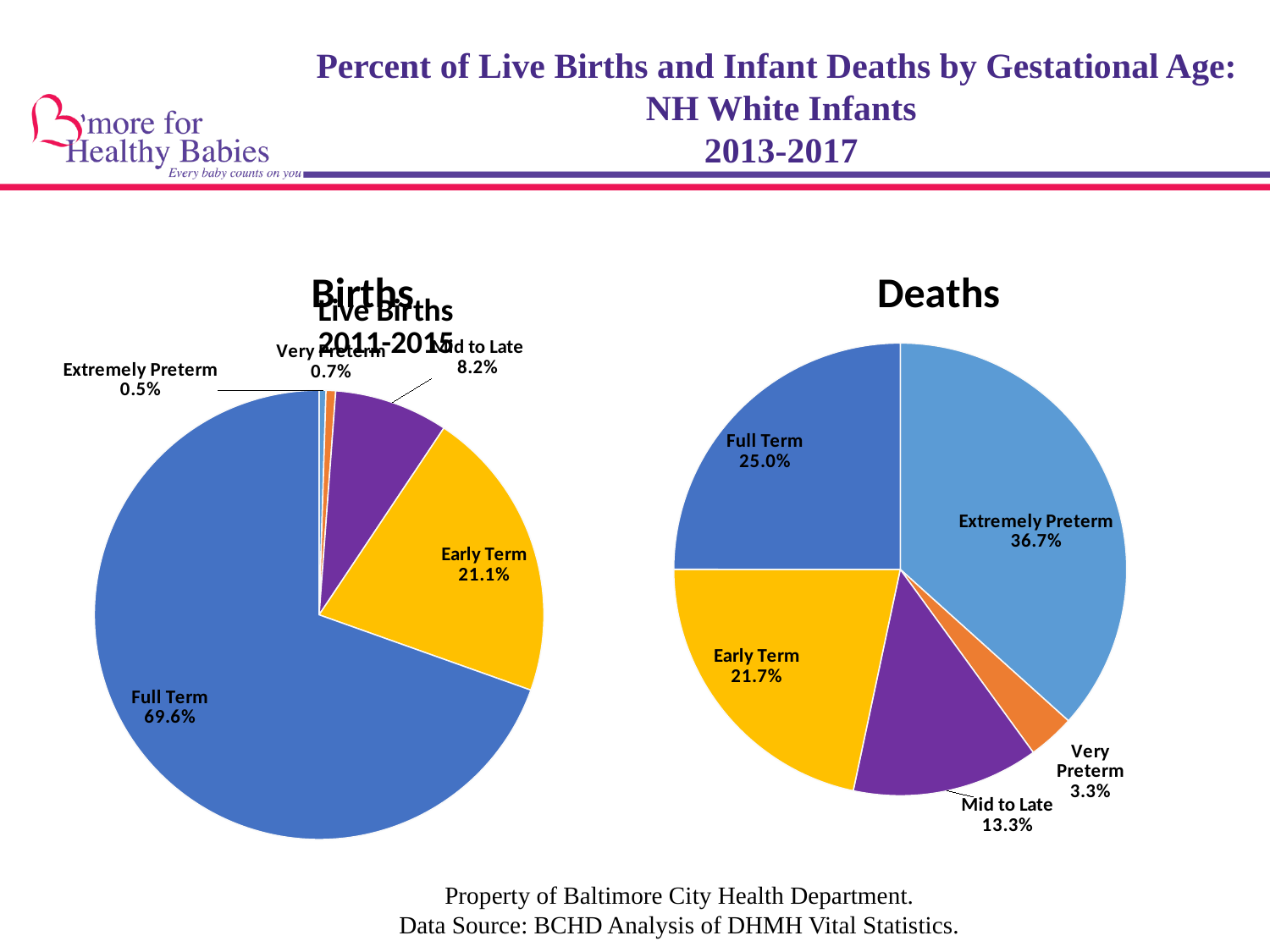
In the Deaths pie chart on the right, which category has the smallest share? Very Preterm In the Births pie chart on the left, what is the value for Early Term? 21.1% In the Births pie chart on the left, which gestational age category has the smallest share? Extremely Preterm In the Births pie chart on the left, what is the difference between the Full Term and Early Term percentages? 48.5% In the Births pie chart on the left, what percentage of live births were Full Term? 69.6% In the Deaths pie chart on the right, what is the difference between the Full Term and Early Term percentages? 3.3% How many gestational age categories are shown in the Deaths pie chart on the right? 5 In the Deaths pie chart on the right, what percentage of infant deaths were Extremely Preterm? 36.7% What type of chart is used to show the Deaths data on the right? Pie chart In the Deaths pie chart on the right, which gestational age category has the largest share? Extremely Preterm In the Deaths pie chart on the right, what is the value for Mid to Late? 13.3% Which is larger in the Deaths pie chart on the right: the Full Term share or the Mid to Late share? Full Term